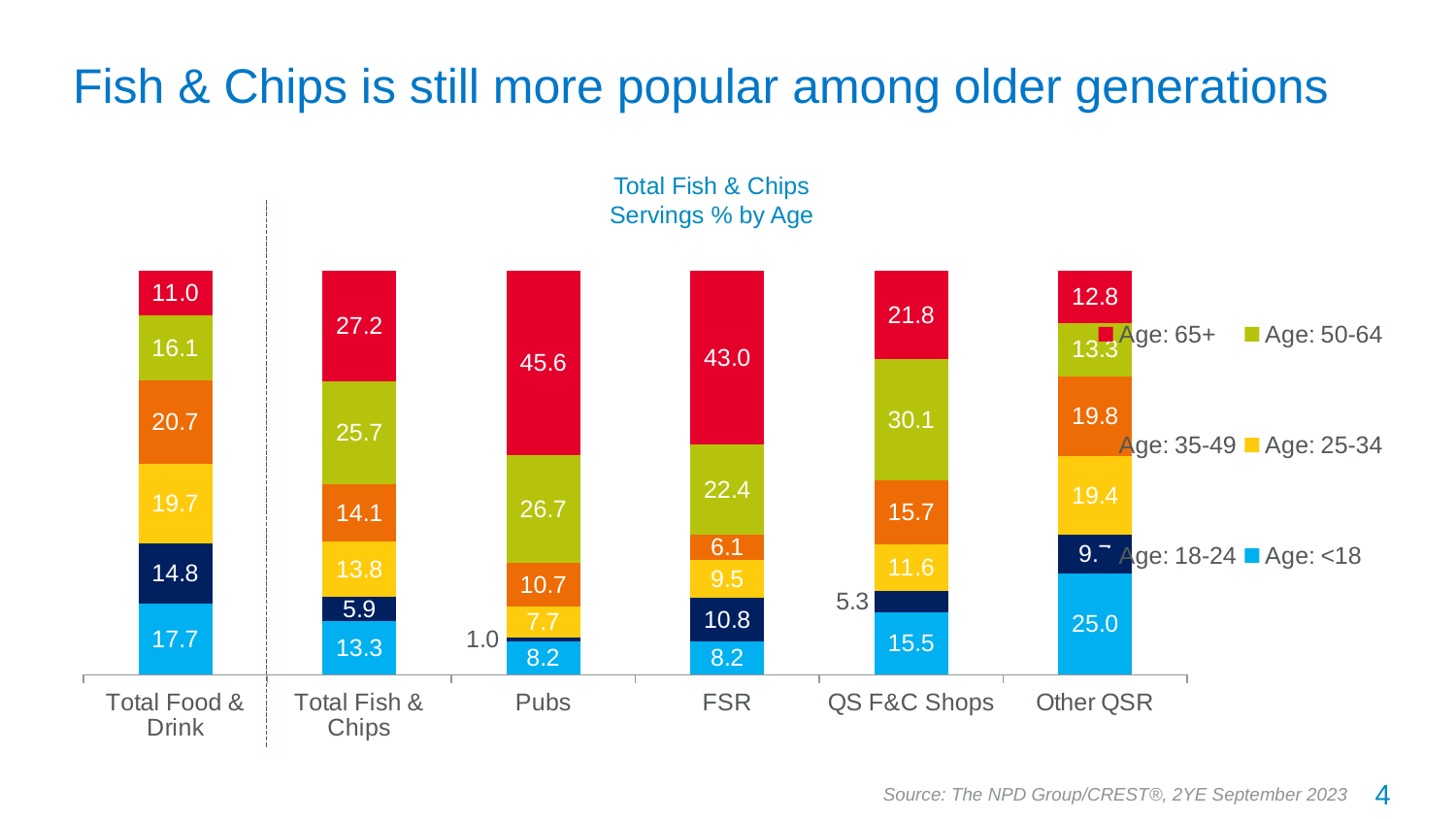
Which category has the highest value for Age: 65+? Pubs How many categories are shown on the x axis? 6 Which category has the lowest value for Age: 18-24? Pubs What is the difference between the Age: 65+ values for FSR and Total Fish & Chips? 15.8 What kind of chart is shown on the slide? Stacked bar chart What is the value for Age: <18 in the Other QSR bar? 25.0 How many series does the legend list? 6 What is the value for Age: 18-24 in the Total Fish & Chips bar? 5.9 What is the title of the chart? Total Fish & Chips Servings % by Age Which has the larger Age: 50-64 value, QS F&C Shops or Total Fish & Chips? QS F&C Shops What is the value for Age: 65+ in the Pubs bar? 45.6 What is the total of the Total Food & Drink stacked bar? 100.0